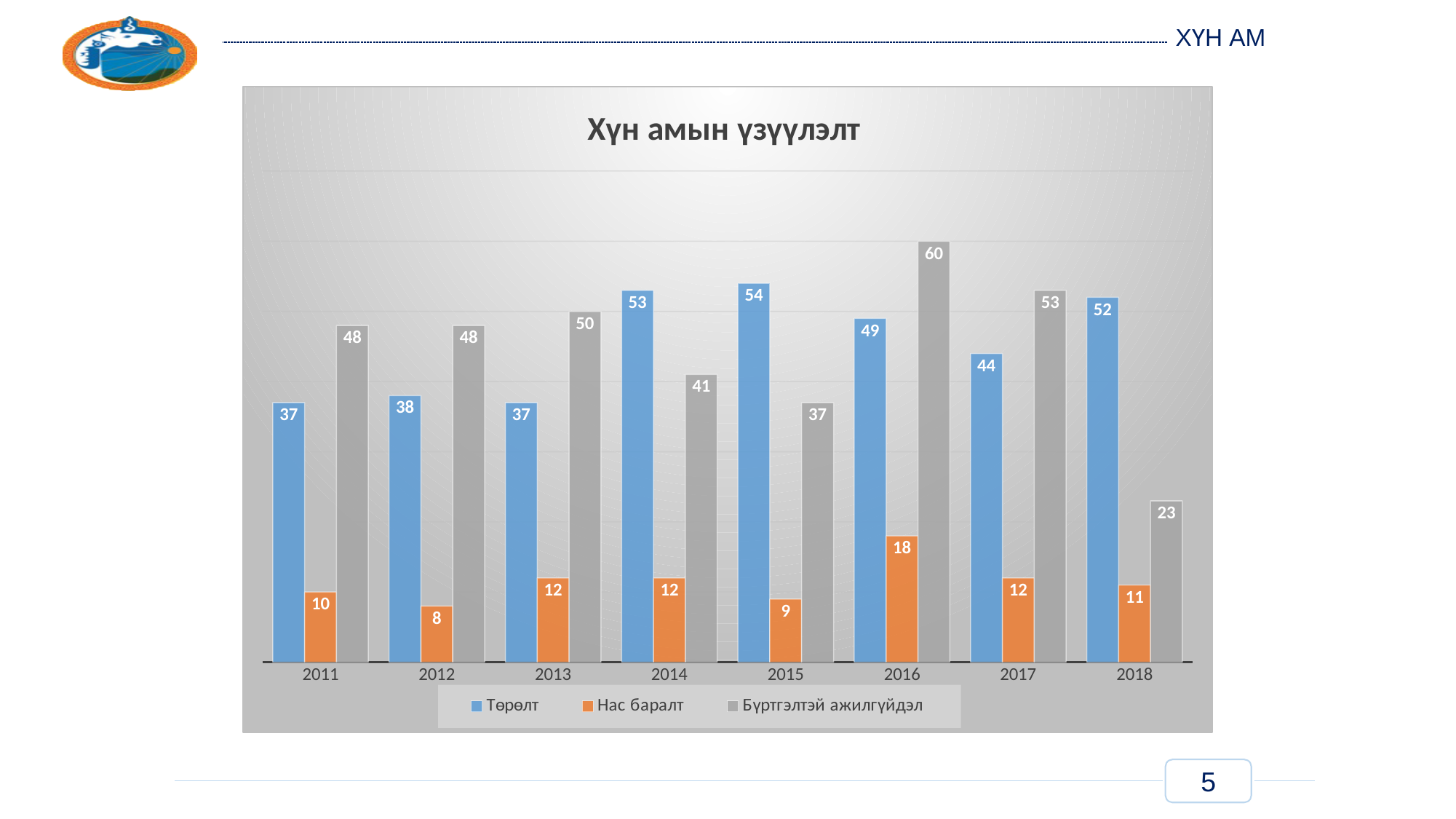
What is the value of Бүртгэлтэй ажилгүйдэл in 2018? 23 What is the value of Төрөлт in 2015? 54 In which year is Бүртгэлтэй ажилгүйдэл highest? 2016 How many series does the legend list? 3 Which is larger in 2017: Төрөлт or Бүртгэлтэй ажилгүйдэл? Бүртгэлтэй ажилгүйдэл How many years are shown on the x axis? 8 In which year is Нас баралт lowest? 2012 Does Төрөлт rise or fall from 2011 to 2015? Rise What kind of chart is shown? Bar chart What is the value of Нас баралт in 2016? 18 What is the title of the chart? Хүн амын үзүүлэлт What is the difference between Төрөлт and Нас баралт in 2014? 41